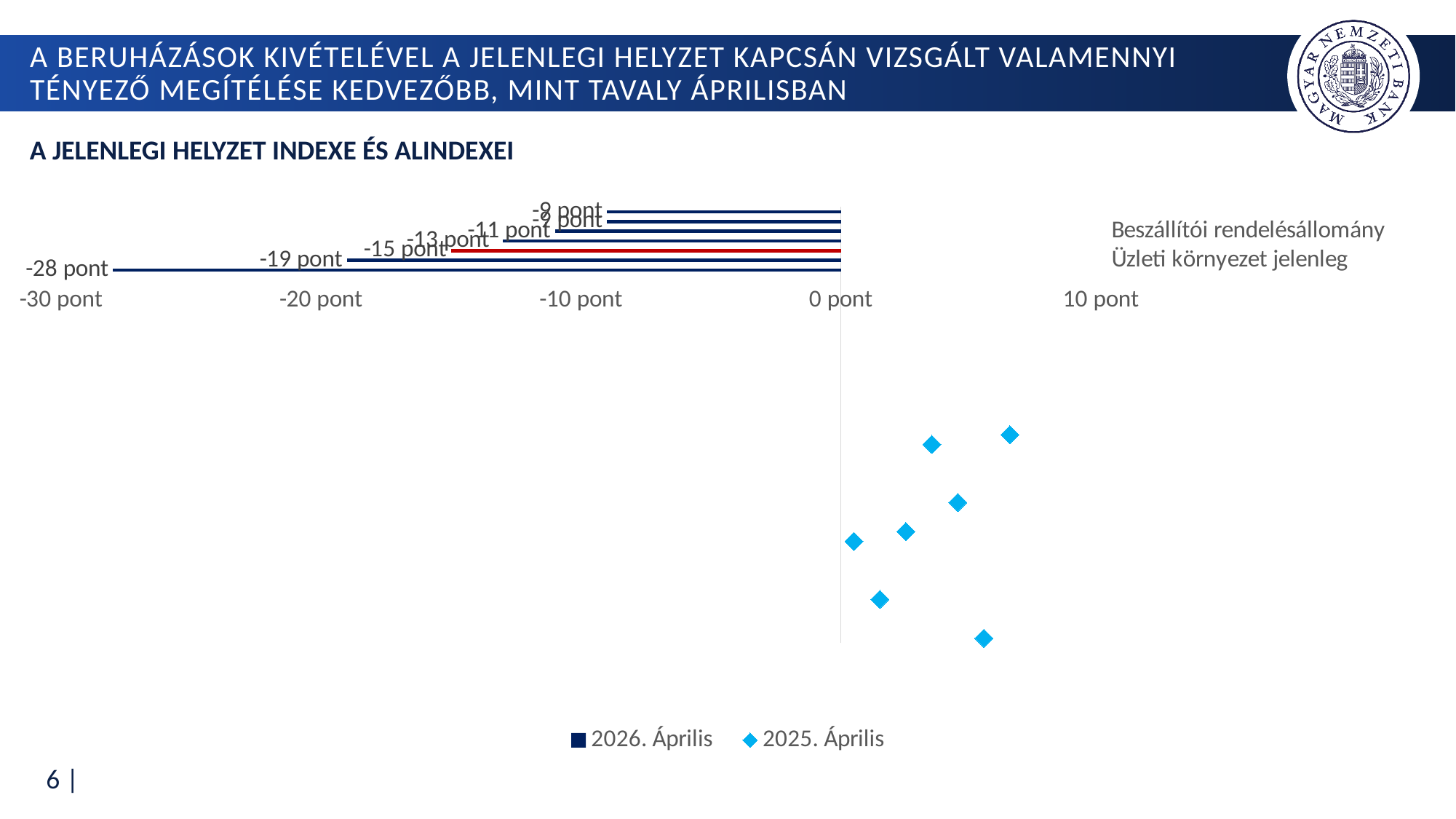
How many series does the legend list? 2 What is the data label on the longest 2026. Április bar? -28 pont What are the two series named in the legend? 2026. Április and 2025. Április What is the difference between the -28 pont bar and the -15 pont bar? 13 pont What is the difference between the -28 pont bar and the -19 pont bar? 9 pont What kind of chart is shown on the slide? bar chart Which is larger, the bar labelled -19 pont or the bar labelled -15 pont? -15 pont What is the lowest value shown by a data label on the 2026. Április bars? -28 pont Are the 2025. Április diamond markers greater or less than 0 pont? greater What is the title of the chart? A JELENLEGI HELYZET INDEXE ÉS ALINDEXEI How many 2025. Április diamond markers are plotted? 7 Are the 2026. Április bar values greater or less than 0 pont? less